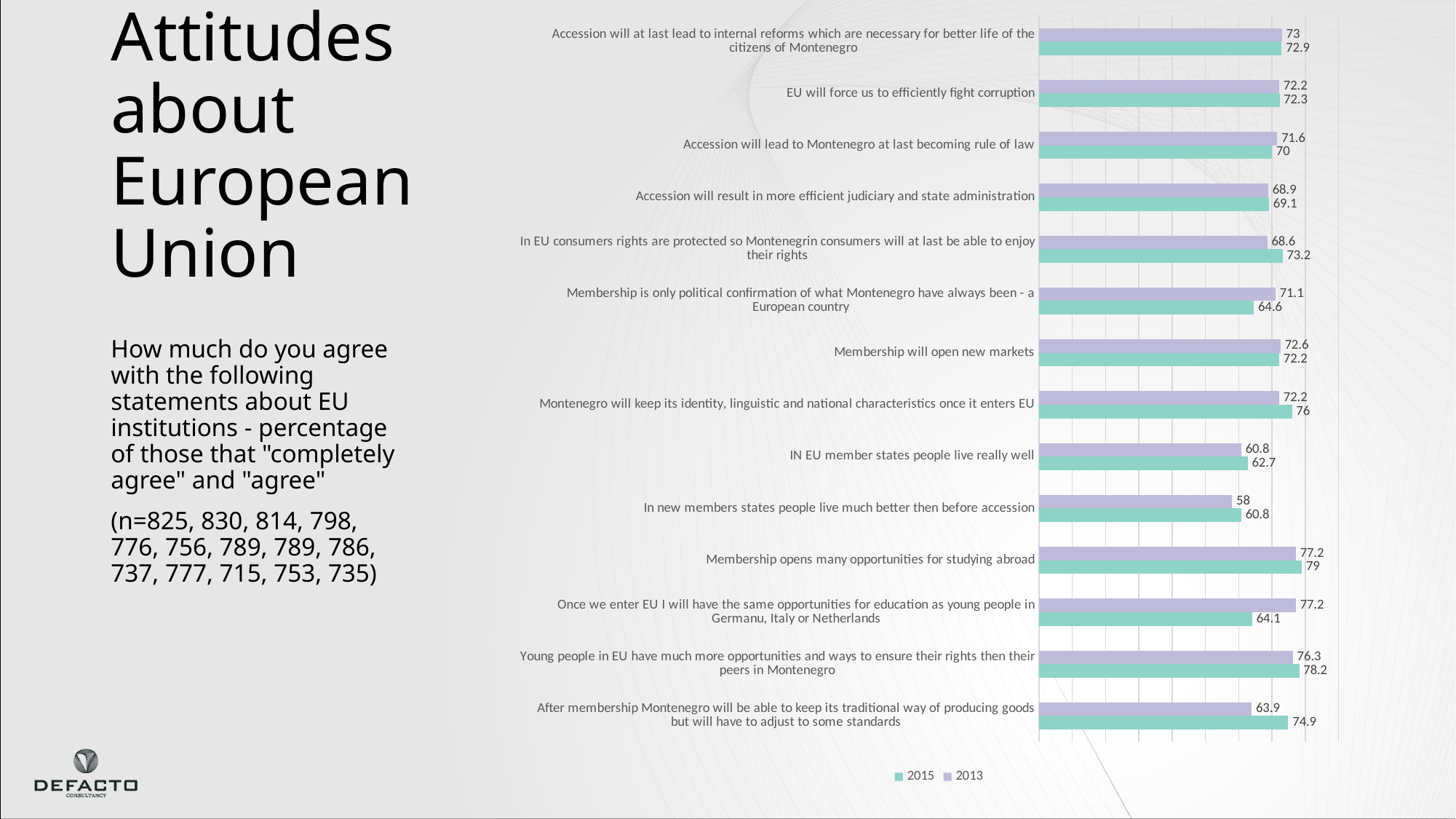
For "Membership is only political confirmation of what Montenegro have always been - a European country", which year has the larger value, 2013 or 2015? 2013 What is the 2015 value for "Membership opens many opportunities for studying abroad"? 79 Which colour represents the 2015 series in the chart? teal (green) What is the difference between the 2013 and 2015 values for "Once we enter EU I will have the same opportunities for education as young people in Germanu, Italy or Netherlands"? 13.1 What is the difference between the 2015 and 2013 values for "Montenegro will keep its identity, linguistic and national characteristics once it enters EU"? 3.8 What is the 2013 value for "In new members states people live much better then before accession"? 58 What kind of chart is shown on the slide? bar chart Which statement has the highest 2015 value? Membership opens many opportunities for studying abroad How many series does the legend list? 2 Which statement has the lowest 2013 value? In new members states people live much better then before accession How many statements (categories) are plotted in the chart? 14 What is the 2015 value for "After membership Montenegro will be able to keep its traditional way of producing goods but will have to adjust to some standards"? 74.9